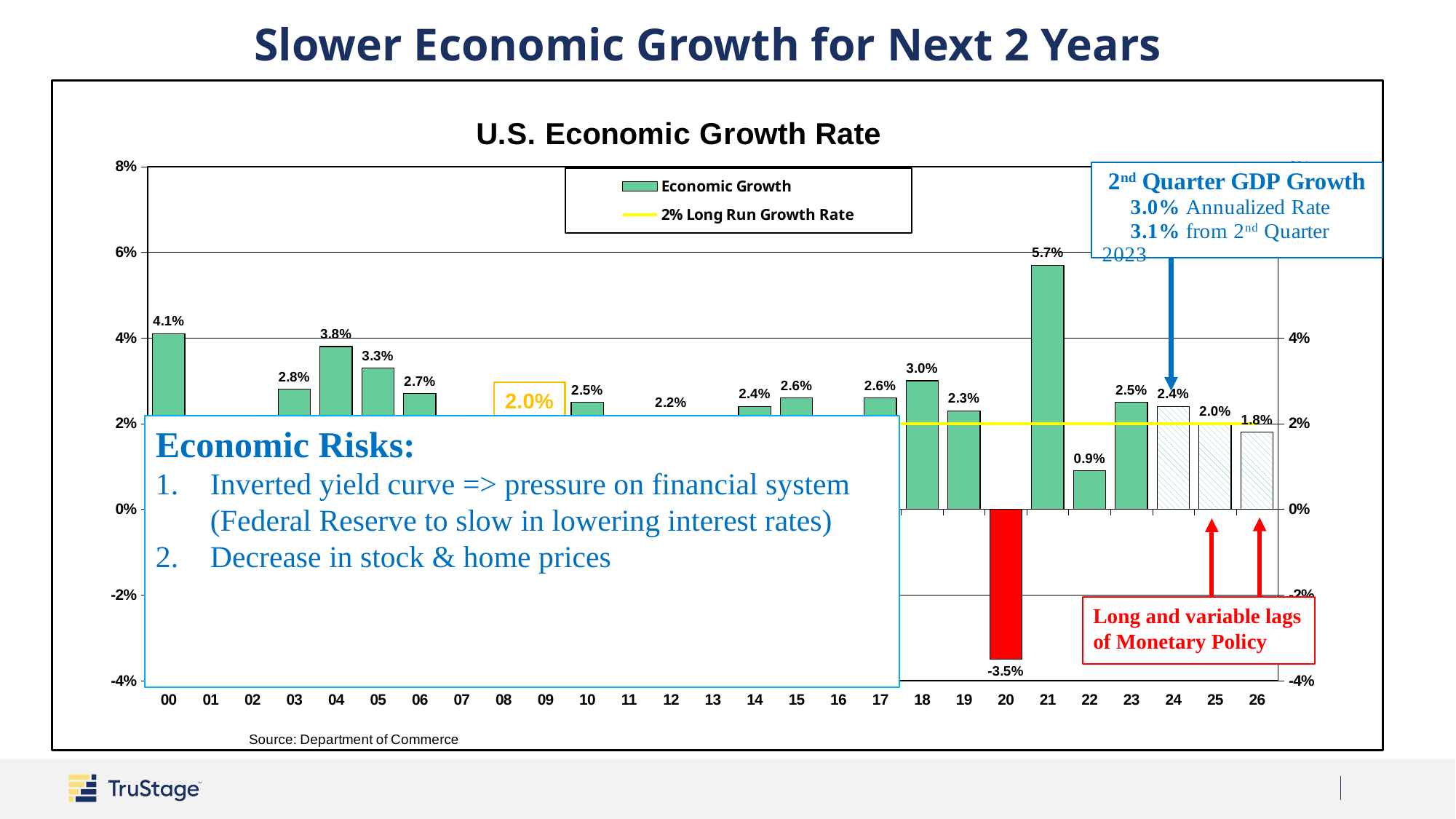
What kind of chart is used to show the U.S. Economic Growth Rate? Bar chart Which year has the highest economic growth rate on the chart? 21 What is the economic growth rate shown for 21? 5.7% What is the forecast economic growth rate shown for 26? 1.8% What is the difference between the growth rate for 21 and the growth rate for 20? 9.2 percentage points What is the source cited for the chart? Department of Commerce What is the economic growth rate shown for 20? -3.5% Which year has the higher growth rate, 04 or 05? 04 How many entries does the legend list? 2 Do the growth rates rise or fall from 24 to 26? Fall What is the economic growth rate shown for 00? 4.1% Which year has the lowest economic growth rate on the chart? 20